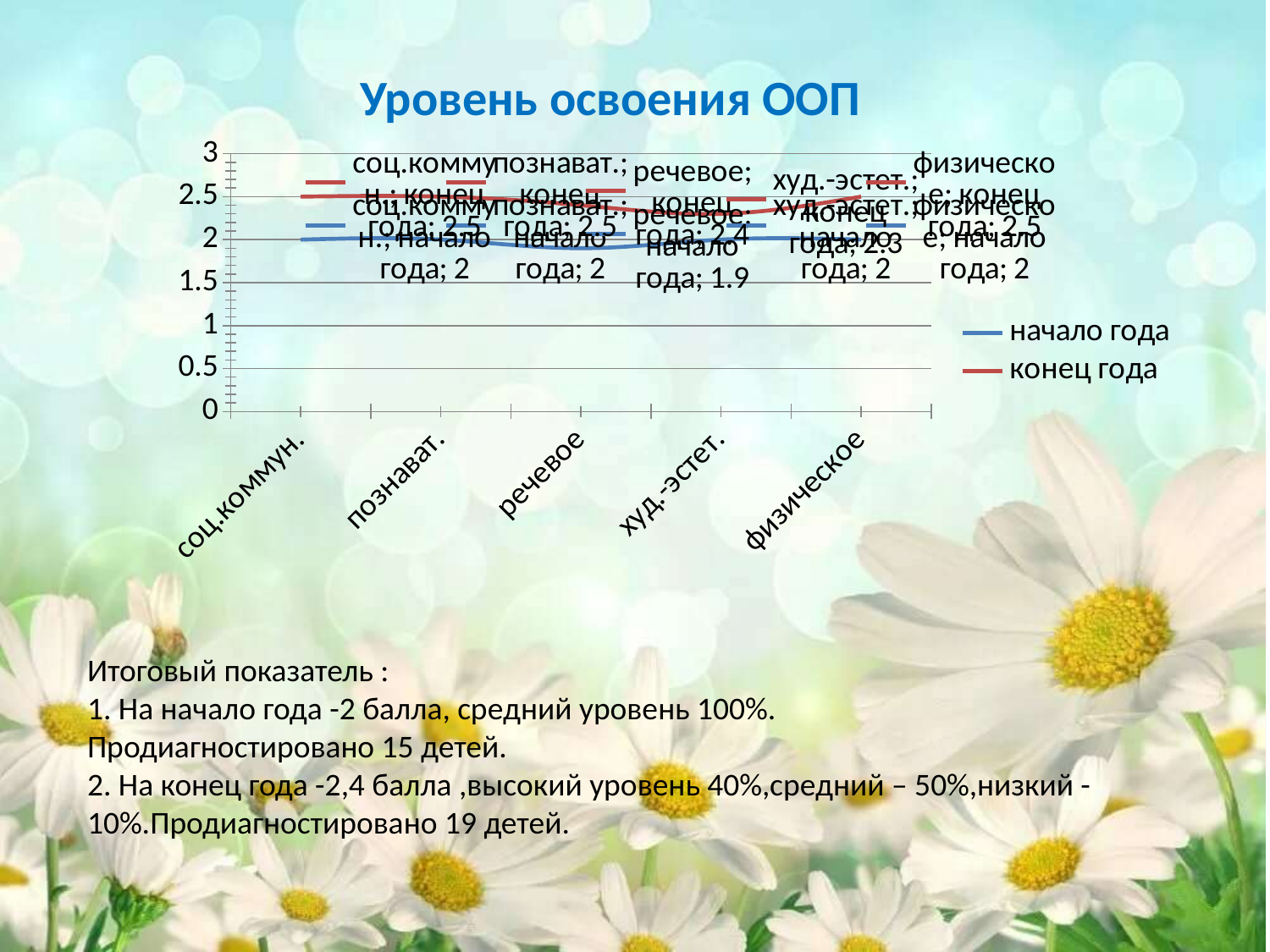
What is the title of the chart? Уровень освоения ООП What is the value for речевое in the конец года series? 2.4 How many categories are shown on the x axis? 5 What type of chart is shown on the slide? line chart What is the value for худ.-эстет. in the конец года series? 2.3 Which series has the higher value for познават., начало года or конец года? конец года Which category has the lowest value in the начало года series? речевое What is the value for физическое in the начало года series? 2 What is the difference between the конец года and начало года values for речевое? 0.5 What is the value for речевое in the начало года series? 1.9 Which category has the lowest value in the конец года series? худ.-эстет. How many series does the legend list? 2